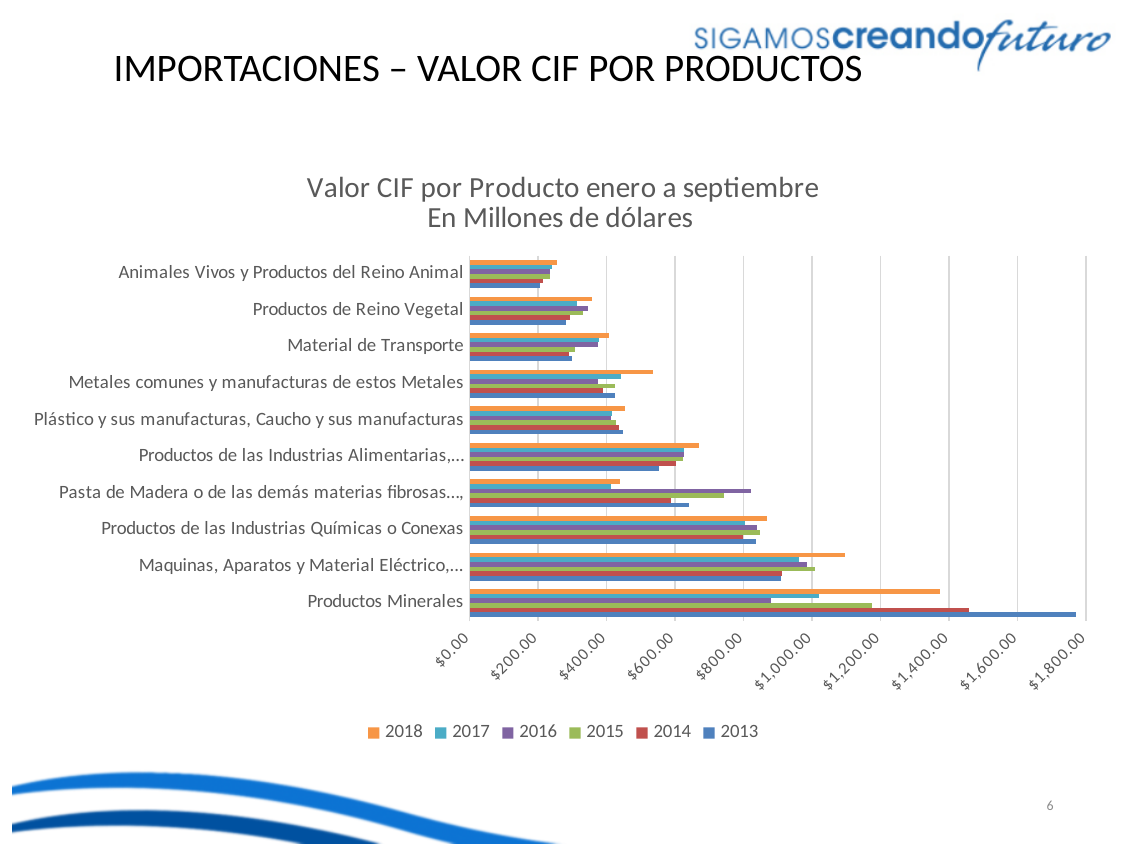
Which product category has the longest bar on the chart? Productos Minerales How many series does the legend list? 6 Which is larger for 2018: Maquinas, Aparatos y Material Eléctrico or Productos de las Industrias Químicas o Conexas? Maquinas, Aparatos y Material Eléctrico What is the title of the chart? Valor CIF por Producto enero a septiembre En Millones de dólares Is the 2013 value for Productos Minerales greater or less than $1,600.00? greater Is the 2018 value for Maquinas, Aparatos y Material Eléctrico greater or less than $1,000.00? greater Is the 2018 value for Animales Vivos y Productos del Reino Animal greater or less than $400.00? less How many product categories are plotted on the chart? 10 What kind of chart is shown on the slide? bar chart For Productos Minerales, which year has the lowest value? 2016 For Productos Minerales, which year has the highest value? 2013